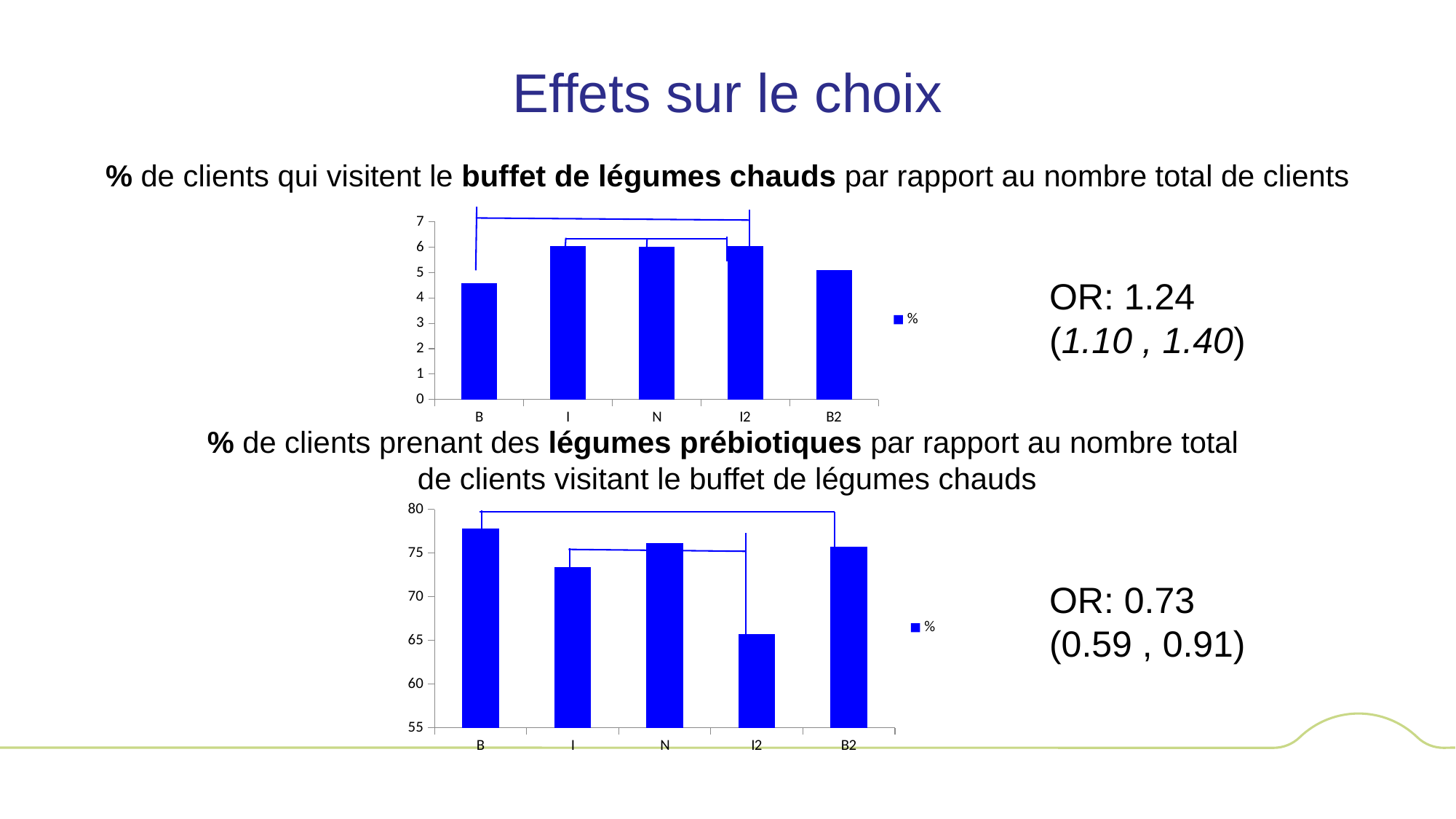
In the bottom chart (légumes prébiotiques), which category has the lowest value? I2 In the top chart (buffet de légumes chauds), is the value for B greater or less than 5? less How many categories are shown on the x axis of the top chart (buffet de légumes chauds)? 5 How many series does the legend of the bottom chart (légumes prébiotiques) list? 1 In the top chart (buffet de légumes chauds), is the value for I greater or less than 5? greater In the top chart (buffet de légumes chauds), which category has the lowest value? B In the bottom chart (légumes prébiotiques), is the value for B greater or less than 75? greater In the top chart (buffet de légumes chauds), which is larger, the value for B or the value for I? I What kind of chart is the top chart (% de clients qui visitent le buffet de légumes chauds)? bar chart What is the legend entry shown next to the top chart (buffet de légumes chauds)? % In the bottom chart (légumes prébiotiques), which is larger, the value for I2 or the value for B2? B2